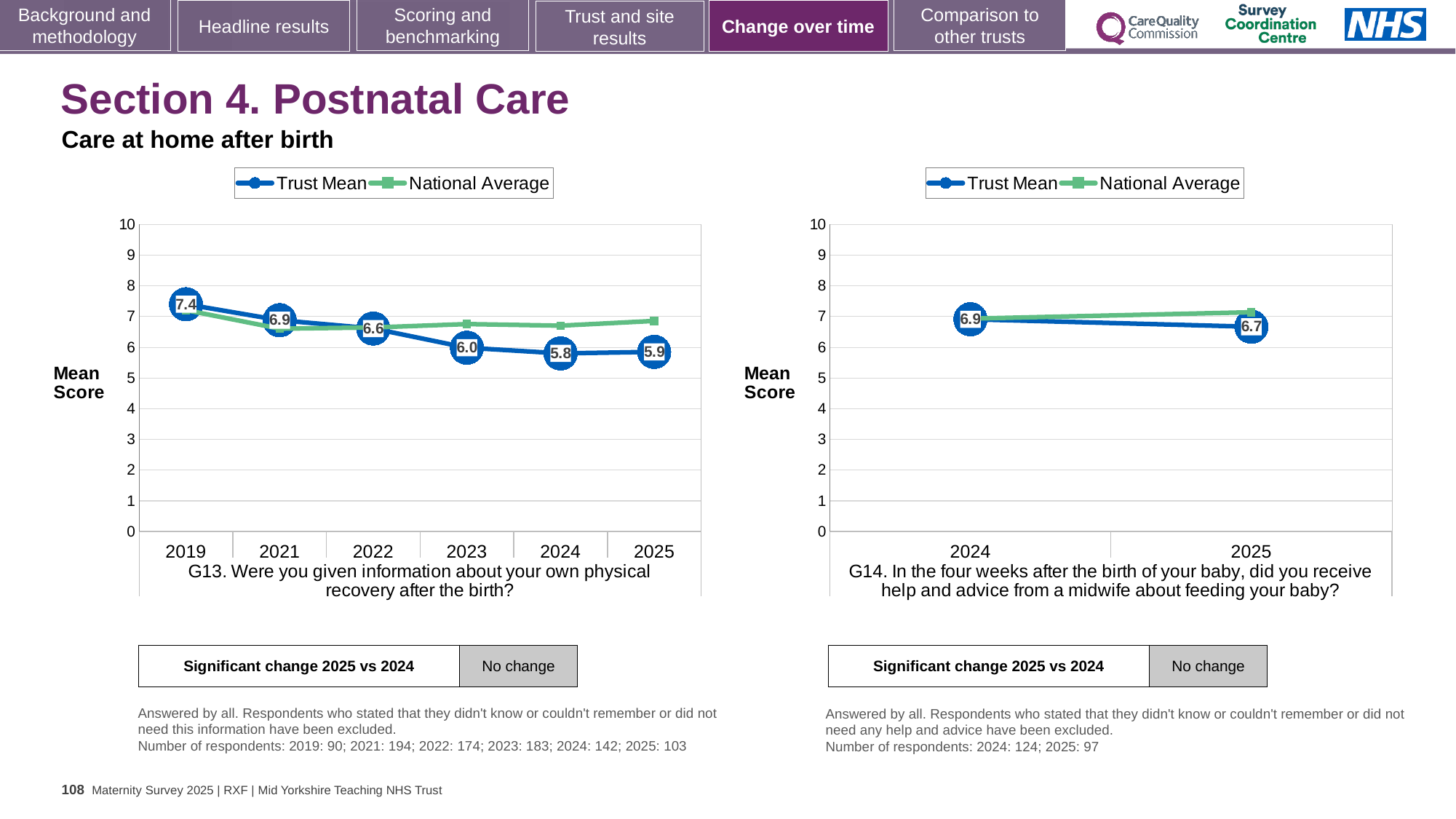
How many series does the legend of the G13 chart on the left list? 2 In the G13 chart on the left, does the Trust Mean generally rise or fall from 2019 to 2024? fall In the G14 chart on the right, what is the Trust Mean score for 2025? 6.7 In the G13 chart on the left, how many years are plotted on the x axis? 6 In the G13 chart on the left, which year has the highest Trust Mean score? 2019 In the G14 chart on the right, what is the Trust Mean score for 2024? 6.9 In the G13 chart on the left, what is the difference between the Trust Mean scores for 2019 and 2025? 1.5 In the G14 chart on the right, is the National Average for 2025 greater or less than 6? greater In the G13 chart on the left, which year has the lowest Trust Mean score? 2024 In the G13 chart on the left, what is the Trust Mean score for 2025? 5.9 In the G13 chart on the left, what is the Trust Mean score for 2019? 7.4 In the G13 chart on the left, what is the Trust Mean score for 2023? 6.0